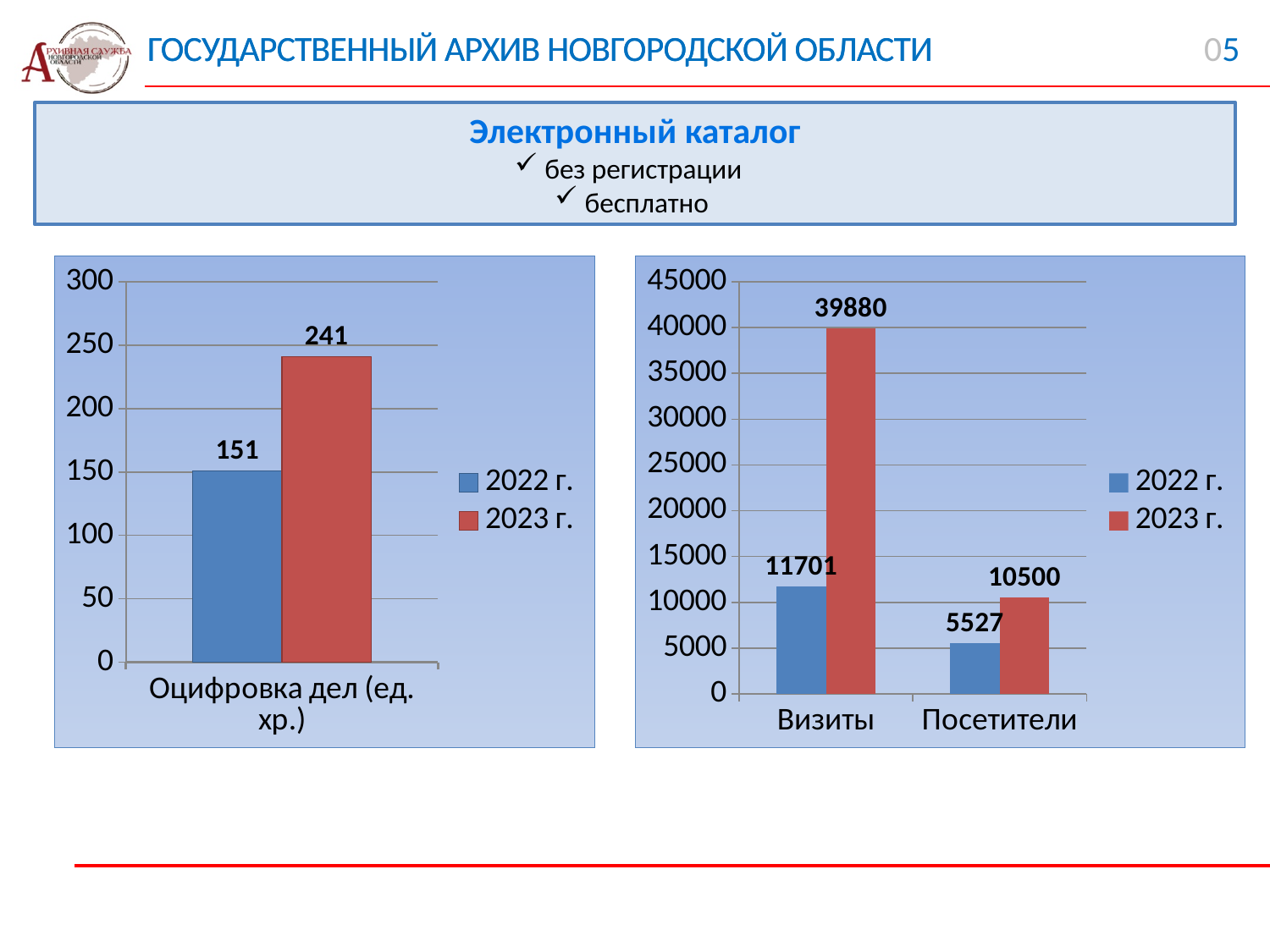
In the left chart, how many series does the legend list? 2 In the right chart, what is the value for 2022 г. for Посетители? 5527 In the right chart, which category has the highest value for 2023 г.? Визиты In the right chart, which is larger: the 2022 г. value for Визиты or the 2023 г. value for Посетители? 2022 г. value for Визиты In the right chart, what is the difference between the 2023 г. and 2022 г. values for Посетители? 4973 In the right chart, what is the value for 2022 г. for Визиты? 11701 In the left chart, what kind of chart is shown? bar chart In the left chart, what is the difference between the 2023 г. and 2022 г. values for Оцифровка дел (ед. хр.)? 90 In the left chart, what is the value for 2023 г. for Оцифровка дел (ед. хр.)? 241 In the right chart, how many categories are shown on the x axis? 2 In the right chart, what is the value for 2023 г. for Визиты? 39880 In the left chart, what is the value for 2022 г. for Оцифровка дел (ед. хр.)? 151